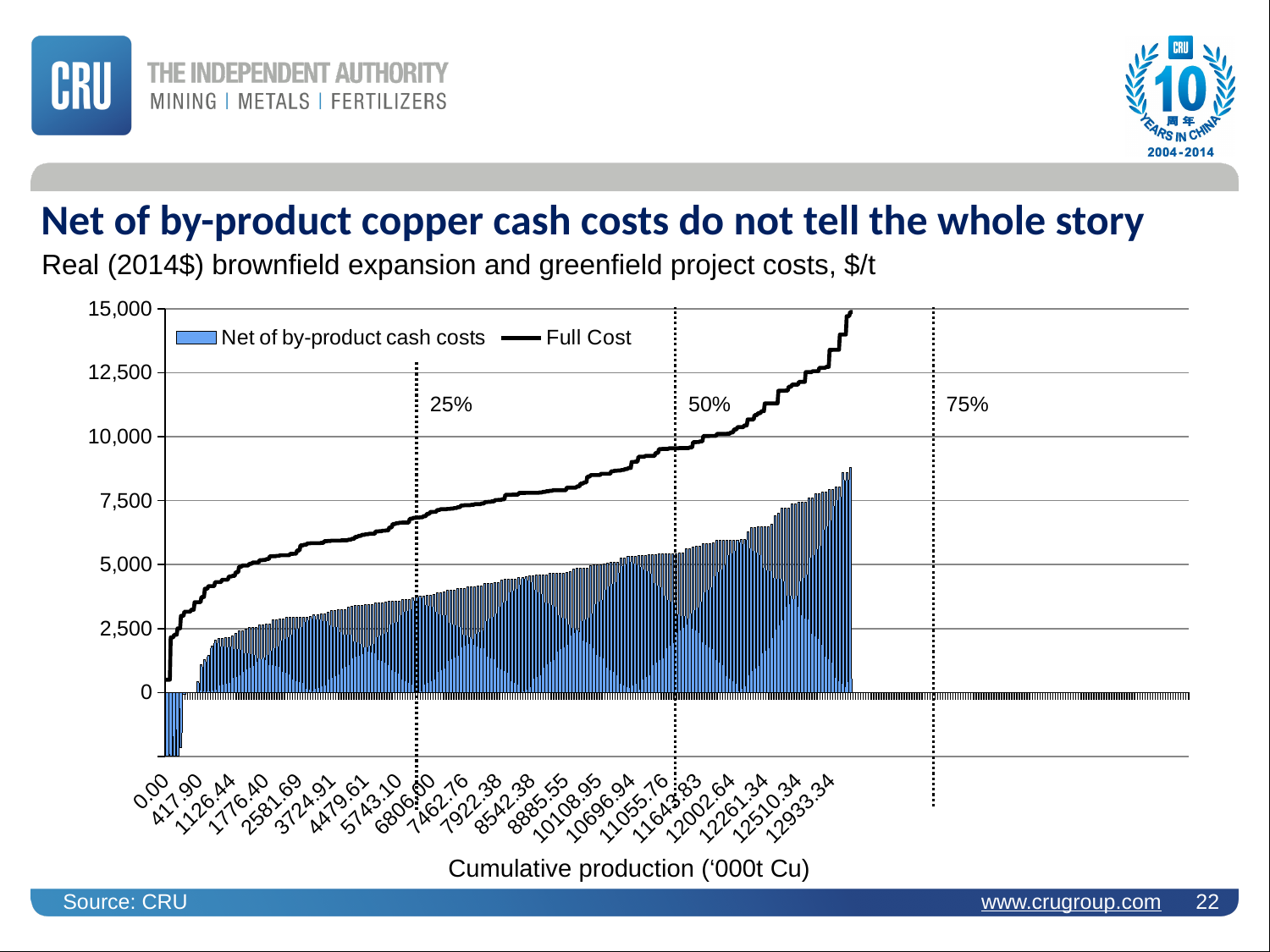
What kind of chart is shown on the slide? A bar chart combined with a line At the 50% dotted marker, is the Net of by-product cash costs value greater or less than 2,500? greater Does the Full Cost line rise or fall as cumulative production increases along the x axis? Rises At the 25% dotted marker, is the Full Cost value greater or less than 5,000? greater What is the title of the horizontal axis? Cumulative production ('000t Cu) At the start of the x axis (0.00), is the Net of by-product cash costs value greater or less than 0? less What are the two series named in the legend? Net of by-product cash costs and Full Cost How many series does the legend list? 2 At the 25% dotted marker, which is larger: the Full Cost or the Net of by-product cash costs? Full Cost